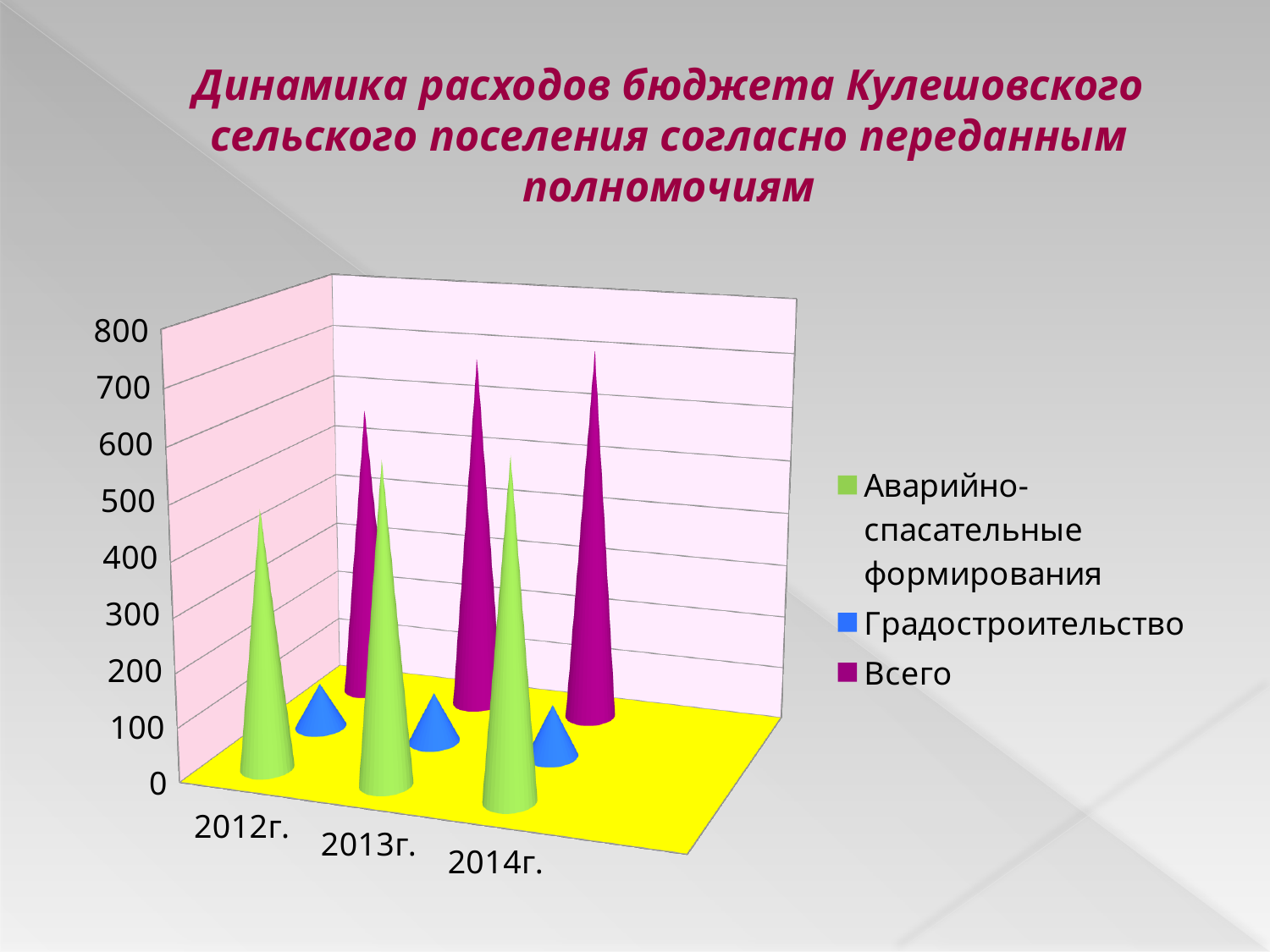
Is the value for Всего in 2012г. greater or less than 400? greater Which is larger in 2013г., Градостроительство or Аварийно-спасательные формирования? Аварийно-спасательные формирования Which series has the lowest value in 2012г.? Градостроительство Does the value for Всего rise or fall from 2012г. to 2014г.? rises Is the value for Градостроительство in 2012г. greater or less than 200? less Which series has the highest value in 2014г.? Всего What kind of chart is shown on the slide? bar chart What colour represents the Всего series in the chart? magenta (purple) How many years are shown on the x axis of the chart? 3 How many series does the chart legend list? 3 Which is larger in 2012г., Всего or Аварийно-спасательные формирования? Всего Is the value for Аварийно-спасательные формирования in 2012г. greater or less than 600? less